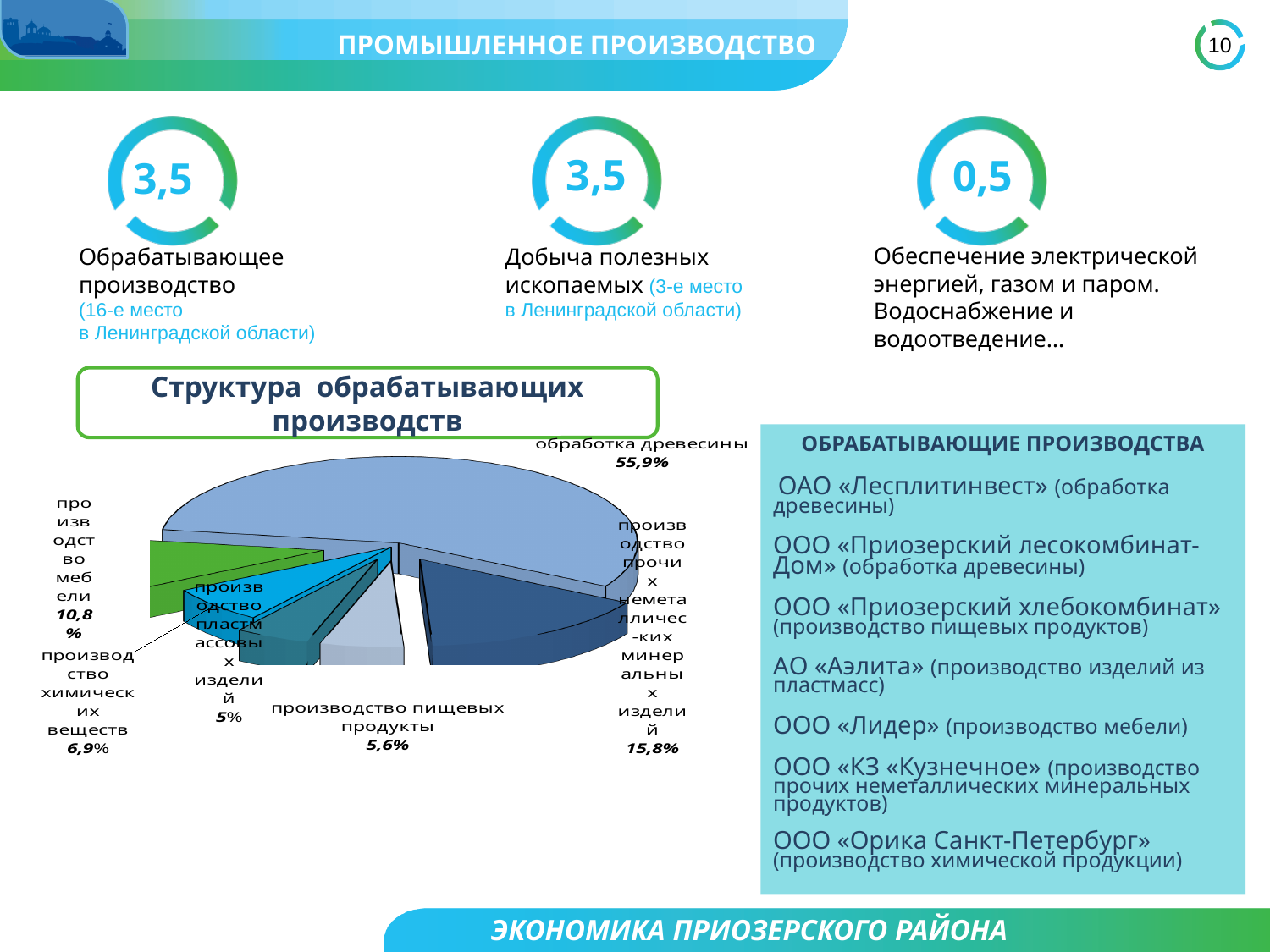
Which slice of the pie chart is the largest? обработка древесины Which slice of the pie chart is the smallest? производство пластмассовых изделий What share of the pie chart does «производство пластмассовых изделий» have? 5% How many slices does the pie chart have? 6 What is the difference in percentage points between «обработка древесины» and «производство прочих неметаллических минеральных изделий»? 40,1 Which is larger in the pie chart: «производство мебели» or «производство химических веществ»? производство мебели What share of the pie chart does «производство мебели» have? 10,8% What share of the pie chart does «производство химических веществ» have? 6,9% What share of the pie chart does «обработка древесины» have? 55,9% What share of the pie chart does «производство пищевых продуктов» have? 5,6% What kind of chart is shown under the title «Структура обрабатывающих производств»? pie chart What share of the pie chart does «производство прочих неметаллических минеральных изделий» have? 15,8%